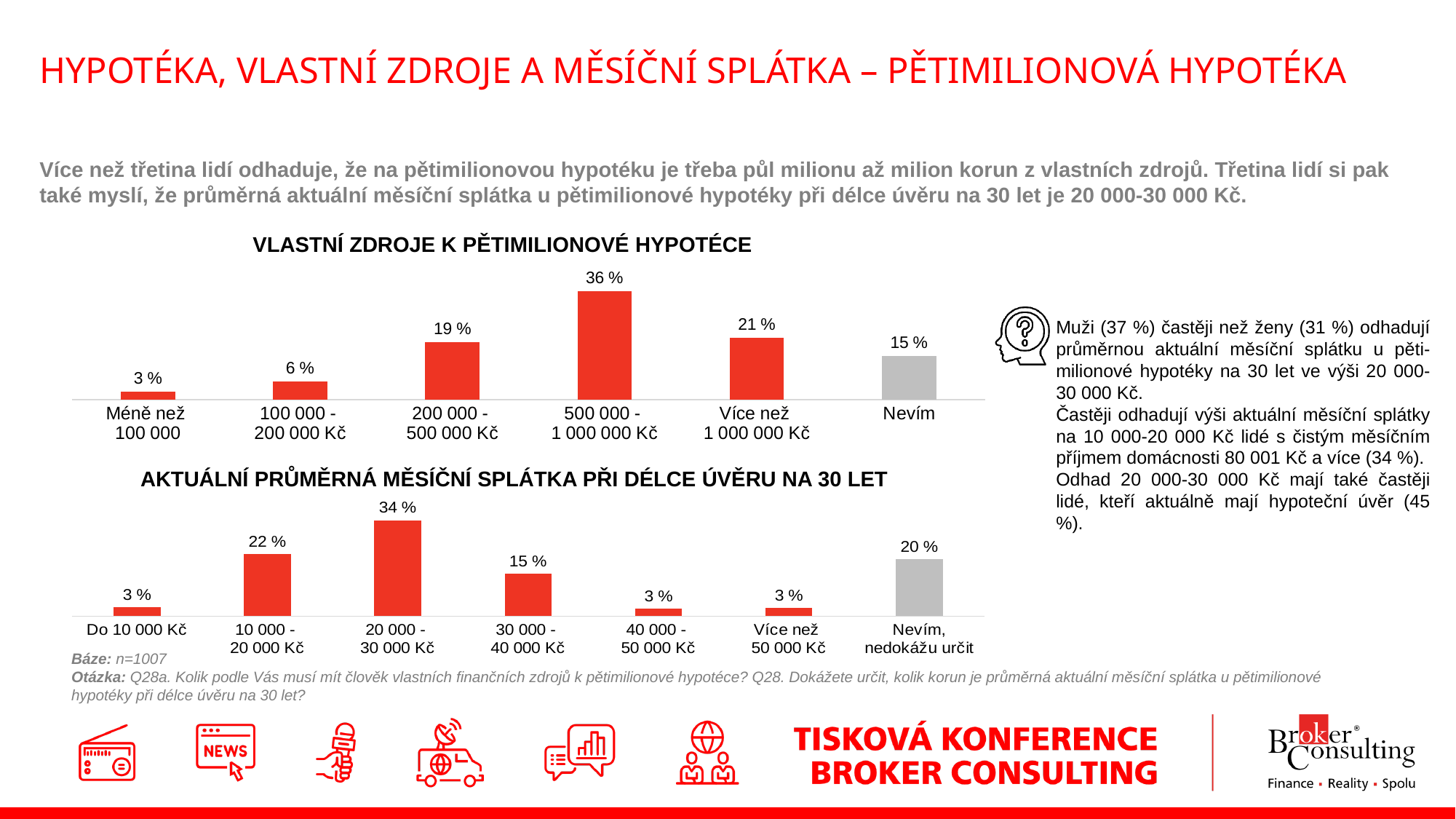
What type of chart is the top chart (VLASTNÍ ZDROJE K PĚTIMILIONOVÉ HYPOTÉCE)? Bar chart In the bottom chart (AKTUÁLNÍ PRŮMĚRNÁ MĚSÍČNÍ SPLÁTKA PŘI DÉLCE ÚVĚRU NA 30 LET), what is the value for Nevím, nedokážu určit? 20 % In the bottom chart (AKTUÁLNÍ PRŮMĚRNÁ MĚSÍČNÍ SPLÁTKA PŘI DÉLCE ÚVĚRU NA 30 LET), which category has the highest value? 20 000 - 30 000 Kč In the top chart (VLASTNÍ ZDROJE K PĚTIMILIONOVÉ HYPOTÉCE), what is the difference between the values for Více než 1 000 000 Kč and 200 000 - 500 000 Kč? 2 % In the bottom chart (AKTUÁLNÍ PRŮMĚRNÁ MĚSÍČNÍ SPLÁTKA PŘI DÉLCE ÚVĚRU NA 30 LET), which is larger: the value for 30 000 - 40 000 Kč or the value for 40 000 - 50 000 Kč? 30 000 - 40 000 Kč In the bottom chart (AKTUÁLNÍ PRŮMĚRNÁ MĚSÍČNÍ SPLÁTKA PŘI DÉLCE ÚVĚRU NA 30 LET), what is the value for 10 000 - 20 000 Kč? 22 % In the top chart (VLASTNÍ ZDROJE K PĚTIMILIONOVÉ HYPOTÉCE), what is the value for Nevím? 15 % In the top chart (VLASTNÍ ZDROJE K PĚTIMILIONOVÉ HYPOTÉCE), how many categories are shown? 6 In the bottom chart (AKTUÁLNÍ PRŮMĚRNÁ MĚSÍČNÍ SPLÁTKA PŘI DÉLCE ÚVĚRU NA 30 LET), what is the difference between the values for 20 000 - 30 000 Kč and 10 000 - 20 000 Kč? 12 % In the top chart (VLASTNÍ ZDROJE K PĚTIMILIONOVÉ HYPOTÉCE), what is the value for 500 000 - 1 000 000 Kč? 36 % In the top chart (VLASTNÍ ZDROJE K PĚTIMILIONOVÉ HYPOTÉCE), which category has the lowest value? Méně než 100 000 In the bottom chart (AKTUÁLNÍ PRŮMĚRNÁ MĚSÍČNÍ SPLÁTKA PŘI DÉLCE ÚVĚRU NA 30 LET), how many categories are shown? 7